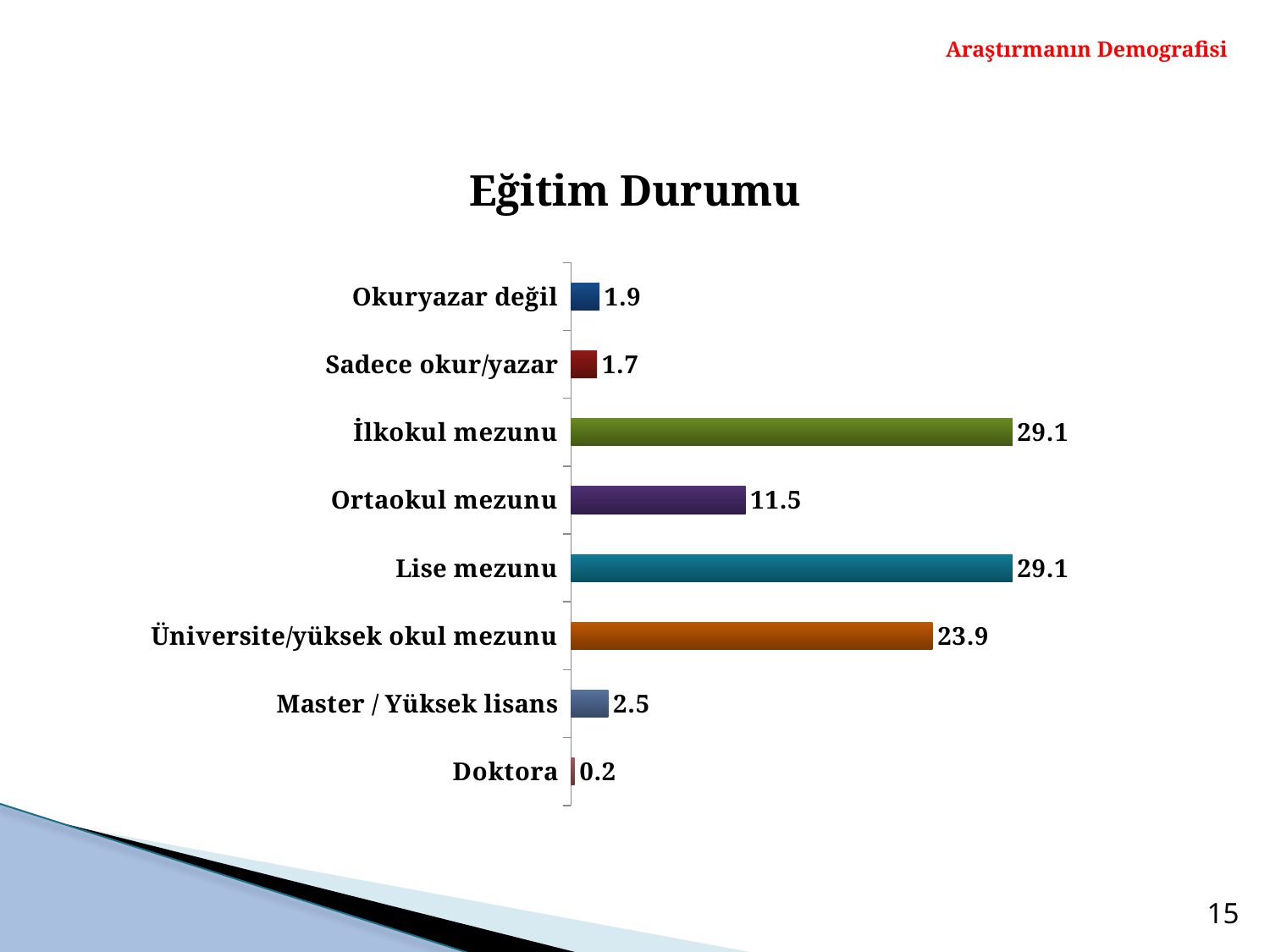
What is the value for Master / Yüksek lisans? 2.5 What is the difference between the values for Lise mezunu and Üniversite/yüksek okul mezunu? 5.2 What is the value for Ortaokul mezunu? 11.5 What is the value for Üniversite/yüksek okul mezunu? 23.9 Which is larger, the value for Okuryazar değil or the value for Master / Yüksek lisans? Master / Yüksek lisans Which category has the lowest value? Doktora What is the title of the chart? Eğitim Durumu What kind of chart is shown on the slide? Bar chart How many categories are shown in the chart? 8 What is the value for Sadece okur/yazar? 1.7 What is the difference between the values for İlkokul mezunu and Ortaokul mezunu? 17.6 Which is larger, the value for Ortaokul mezunu or the value for Üniversite/yüksek okul mezunu? Üniversite/yüksek okul mezunu